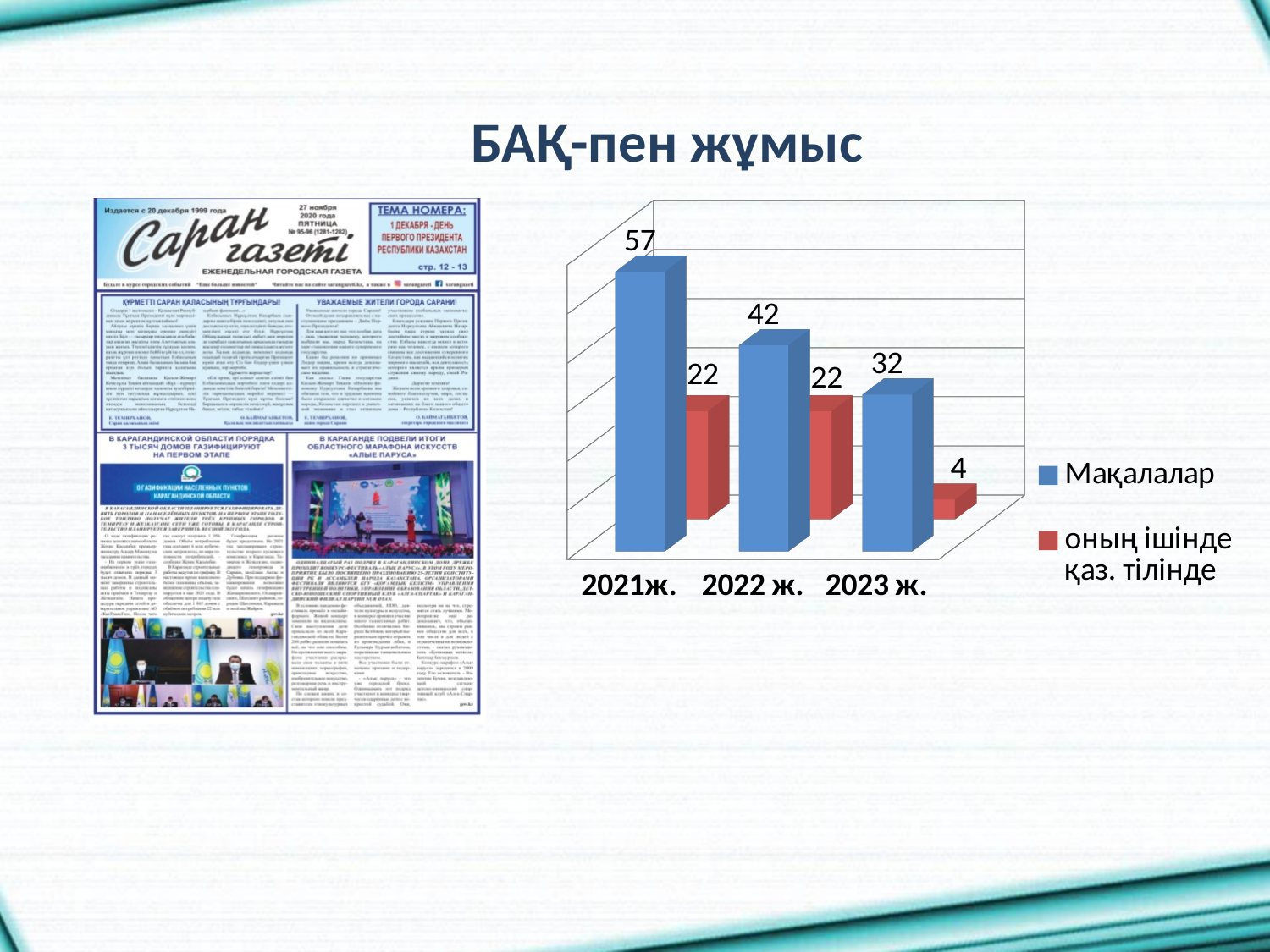
What is the value for Мақалалар in 2021ж.? 57 What is the difference between the Мақалалар values for 2021ж. and 2022 ж.? 15 What is the value for оның ішінде қаз. тілінде in 2023 ж.? 4 Does the value for Мақалалар rise or fall from 2021ж. to 2023 ж.? fall In which year is the value for Мақалалар highest? 2021ж. In which year is the value for оның ішінде қаз. тілінде lowest? 2023 ж. What is the difference between Мақалалар and оның ішінде қаз. тілінде in 2023 ж.? 28 What is the value for Мақалалар in 2022 ж.? 42 How many series does the chart legend list? 2 Which is larger: Мақалалар in 2022 ж. or Мақалалар in 2023 ж.? Мақалалар in 2022 ж. What is the value for оның ішінде қаз. тілінде in 2021ж.? 22 How many years are shown on the x axis of the chart? 3